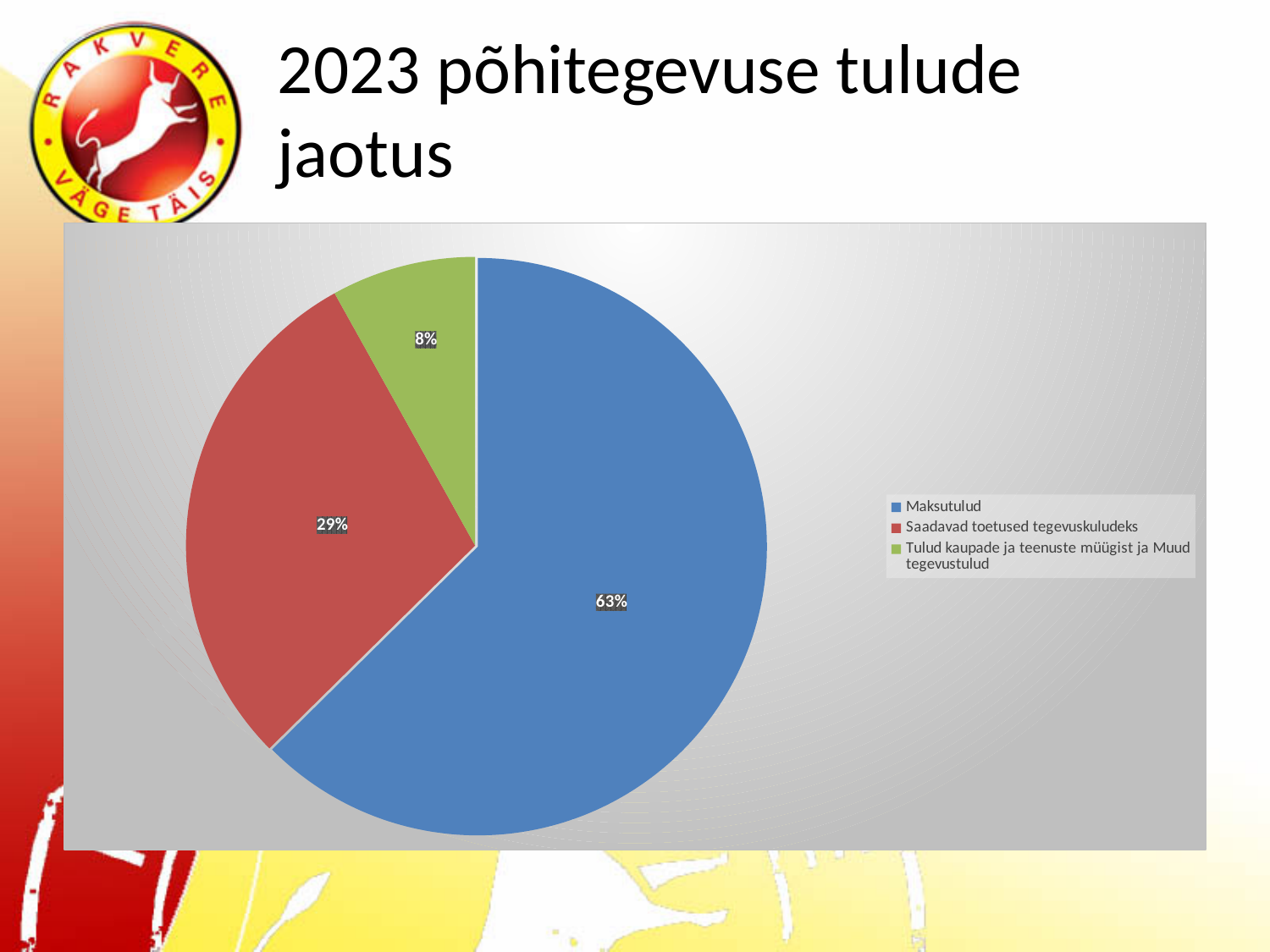
What share of the pie does Maksutulud have? 63% Which is larger, the slice for Maksutulud or the slice for Saadavad toetused tegevuskuludeks? Maksutulud What is the difference in percentage points between Saadavad toetused tegevuskuludeks and Tulud kaupade ja teenuste müügist ja Muud tegevustulud? 21 What share of the pie does Tulud kaupade ja teenuste müügist ja Muud tegevustulud have? 8% Which category has the largest slice of the pie? Maksutulud What kind of chart is shown on the slide? pie chart How many slices does the pie chart have? 3 Which category has the smallest slice of the pie? Tulud kaupade ja teenuste müügist ja Muud tegevustulud How many entries does the legend list? 3 What share of the pie does Saadavad toetused tegevuskuludeks have? 29% What colour is the slice for Maksutulud? blue What is the difference in percentage points between Maksutulud and Saadavad toetused tegevuskuludeks? 34